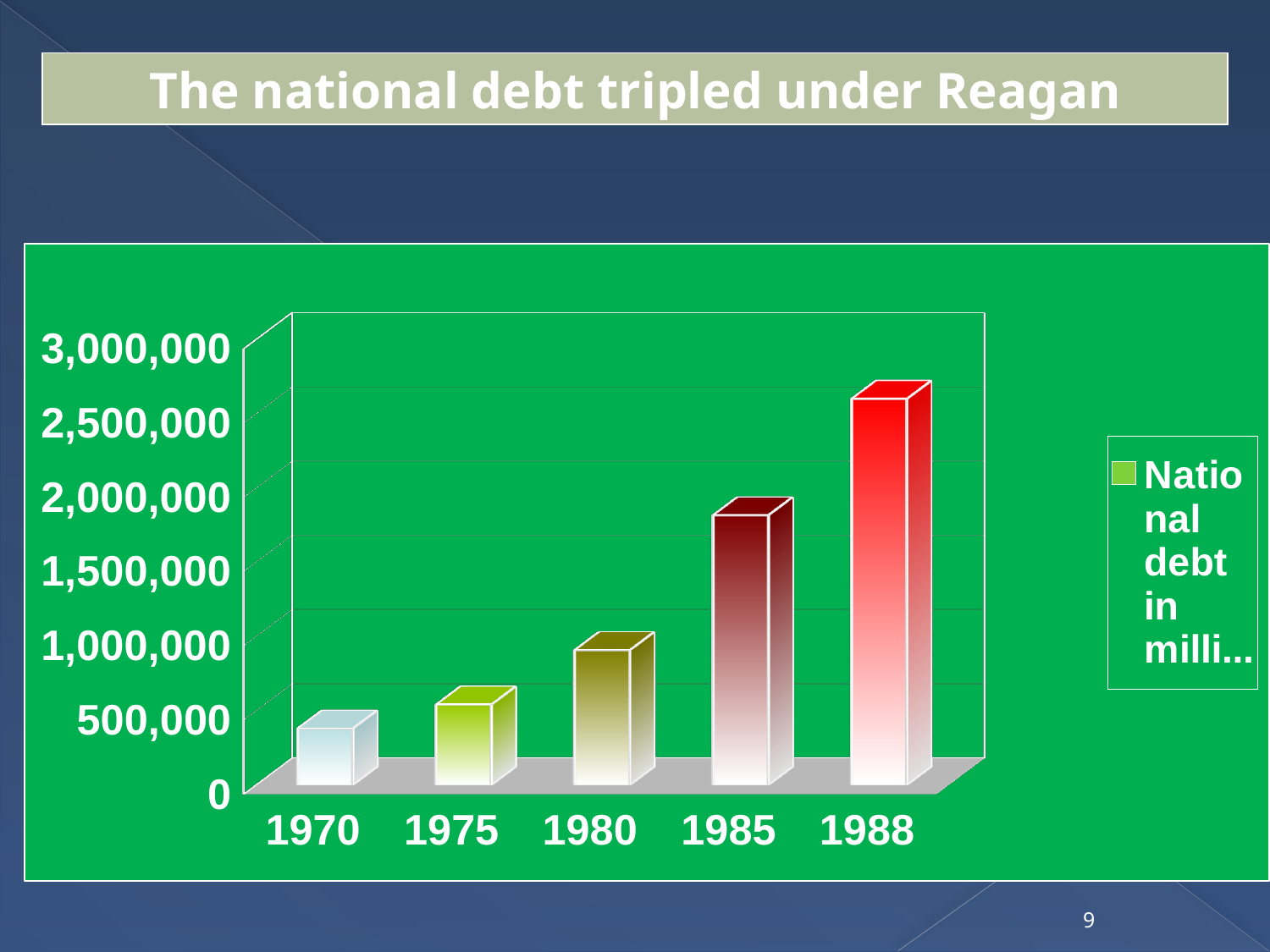
Which year has the lowest bar in the chart? 1970 Is the value for 1980 greater or less than 1,000,000? less Is the value for 1985 greater or less than 1,500,000? greater Which year has the highest bar in the chart? 1988 How many series does the chart's legend list? 1 Which is larger, the value for 1985 or the value for 1980? 1985 What is the title shown above the chart on the slide? The national debt tripled under Reagan What kind of chart is shown on the slide? bar chart Do the values rise or fall from 1970 to 1988 along the x axis? rise Is the value for 1970 greater or less than 500,000? less How many years are shown on the x axis of the chart? 5